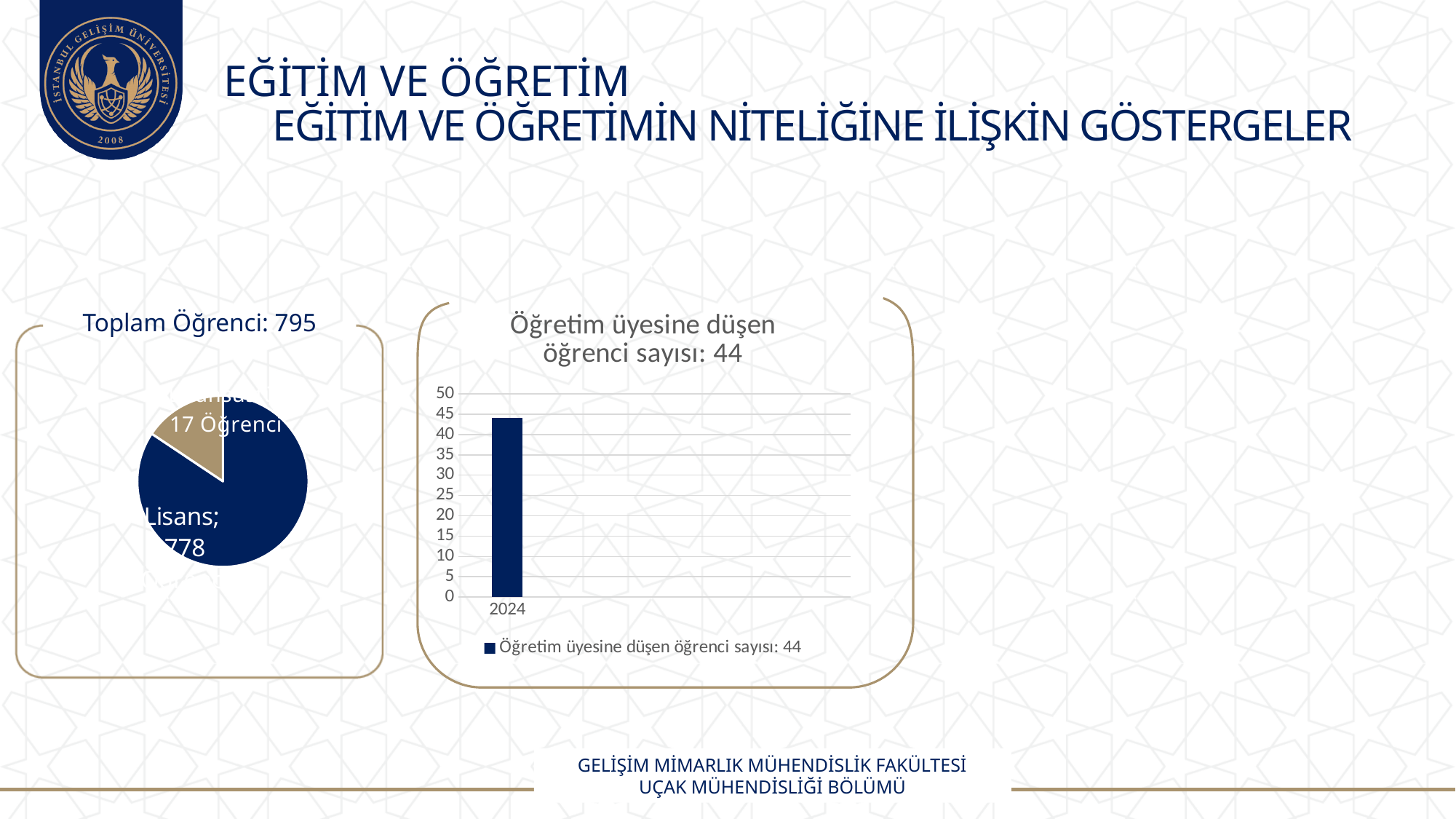
How many slices does the pie chart on the left have? 2 How many bars are plotted in the bar chart on the right? 1 In the bar chart on the right, is the value for 2024 greater or less than 45? less In the bar chart on the right, is the value for 2024 greater or less than 40? greater How many series does the legend of the bar chart on the right list? 1 In the pie chart on the left, which slice is the largest? Lisans In the pie chart on the left, what is the value for Lisans? 778 What is the title of the pie chart on the left? Toplam Öğrenci: 795 What type of chart is the chart on the left titled 'Toplam Öğrenci: 795'? pie chart What type of chart is the chart on the right titled 'Öğretim üyesine düşen öğrenci sayısı: 44'? bar chart In the bar chart on the right, what is the value for 2024? 44 What is the title of the bar chart on the right? Öğretim üyesine düşen öğrenci sayısı: 44